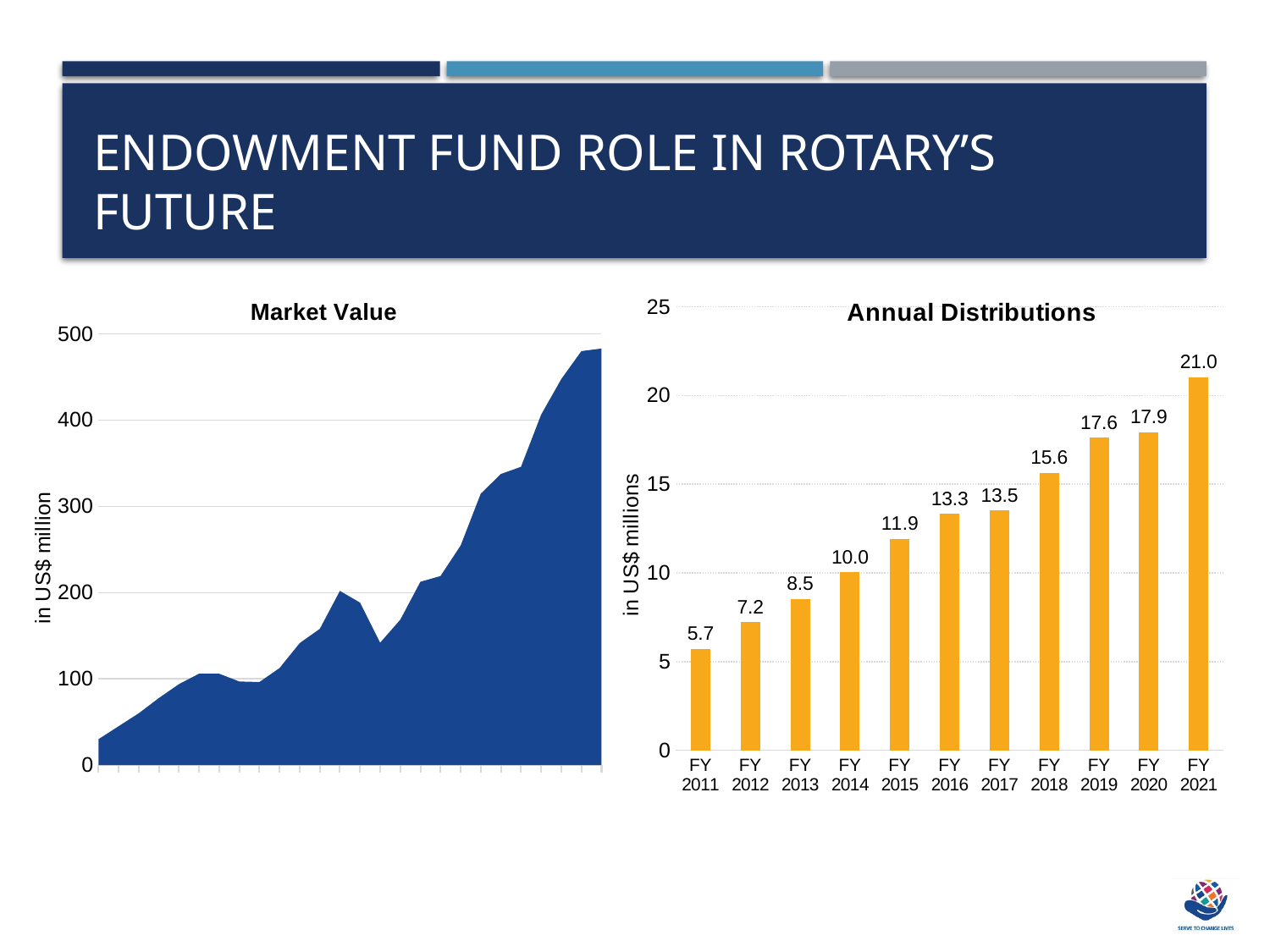
In the Market Value chart, is the highest value reached greater or less than 400? greater What kind of chart is the Annual Distributions chart? Bar chart In the Annual Distributions chart, which fiscal year has the highest value? FY 2021 In the Annual Distributions chart, which is larger, the value for FY 2015 or the value for FY 2013? FY 2015 In the Annual Distributions chart, what is the value for FY 2014? 10.0 In the Annual Distributions chart, what is the difference between the values for FY 2021 and FY 2020? 3.1 In the Annual Distributions chart, what is the value for FY 2011? 5.7 What is the y-axis label of the Market Value chart? in US$ million In the Annual Distributions chart, do the values rise or fall from FY 2011 to FY 2021? Rise In the Annual Distributions chart, which fiscal year has the lowest value? FY 2011 In the Annual Distributions chart, what is the value for FY 2018? 15.6 How many fiscal years are shown in the Annual Distributions chart? 11